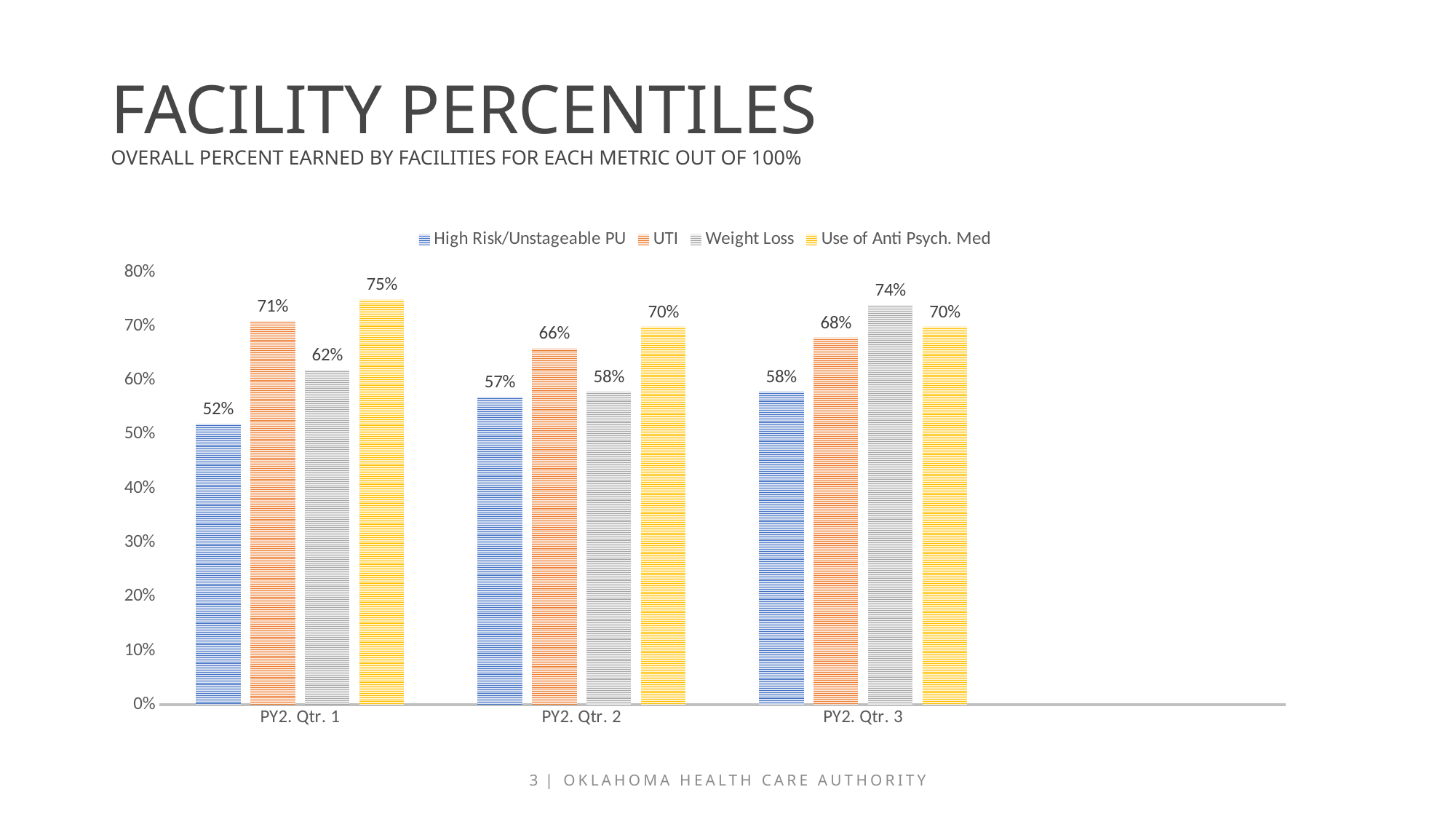
Does the value for High Risk/Unstageable PU rise or fall from PY2. Qtr. 1 to PY2. Qtr. 3? Rise What is the value for Weight Loss in PY2. Qtr. 3? 74% What is the value for UTI in PY2. Qtr. 1? 71% What kind of chart is shown on the slide? Bar chart Which is larger in PY2. Qtr. 2: UTI or Weight Loss? UTI What is the value for High Risk/Unstageable PU in PY2. Qtr. 2? 57% How many series does the legend list? 4 What is the difference between Use of Anti Psych. Med and High Risk/Unstageable PU in PY2. Qtr. 1? 23% Which series has the lowest value in PY2. Qtr. 3? High Risk/Unstageable PU Which series has the highest value in PY2. Qtr. 1? Use of Anti Psych. Med What is the subtitle printed under the slide title? OVERALL PERCENT EARNED BY FACILITIES FOR EACH METRIC OUT OF 100% How many quarters are shown on the x axis? 3